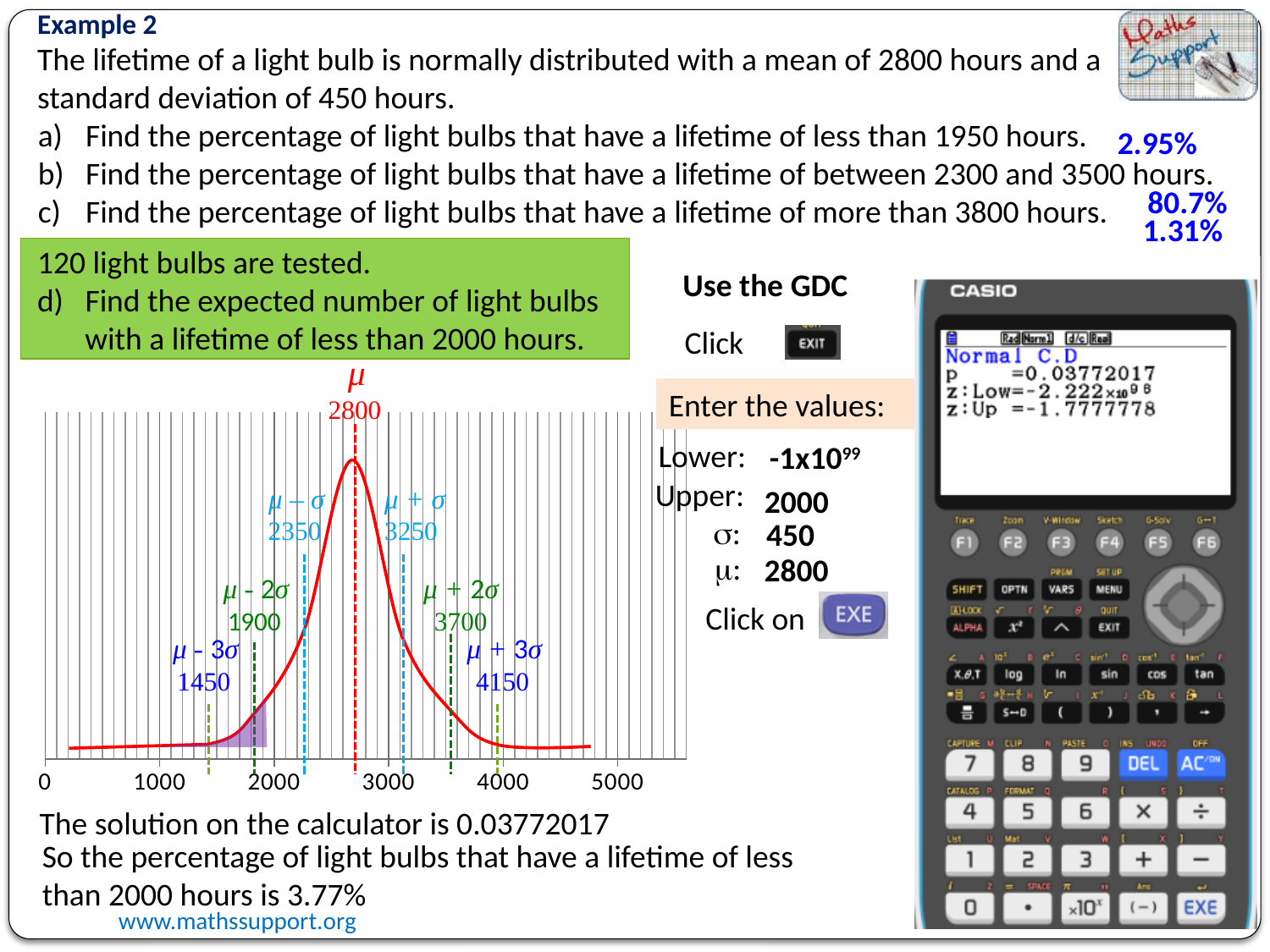
What colour is the curve drawn on the normal distribution chart? red What value is labelled at μ − 3σ on the chart? 1450 What value is labelled at μ + 2σ on the chart? 3700 What is the difference between the values labelled at μ + σ and μ − σ on the chart? 900 What value is labelled at μ − σ on the chart? 2350 What value is labelled at μ + σ on the chart? 3250 Which is larger on the chart, the value labelled at μ + 2σ or the value labelled at μ − 3σ? μ + 2σ Does the curve on the chart rise or fall as x increases from 2800 to 4150? fall What value is labelled at the mean μ on the normal distribution chart? 2800 What value is labelled at μ + 3σ on the chart? 4150 How many numbered tick labels are shown on the x axis of the chart? 6 What value is labelled at μ − 2σ on the chart? 1900